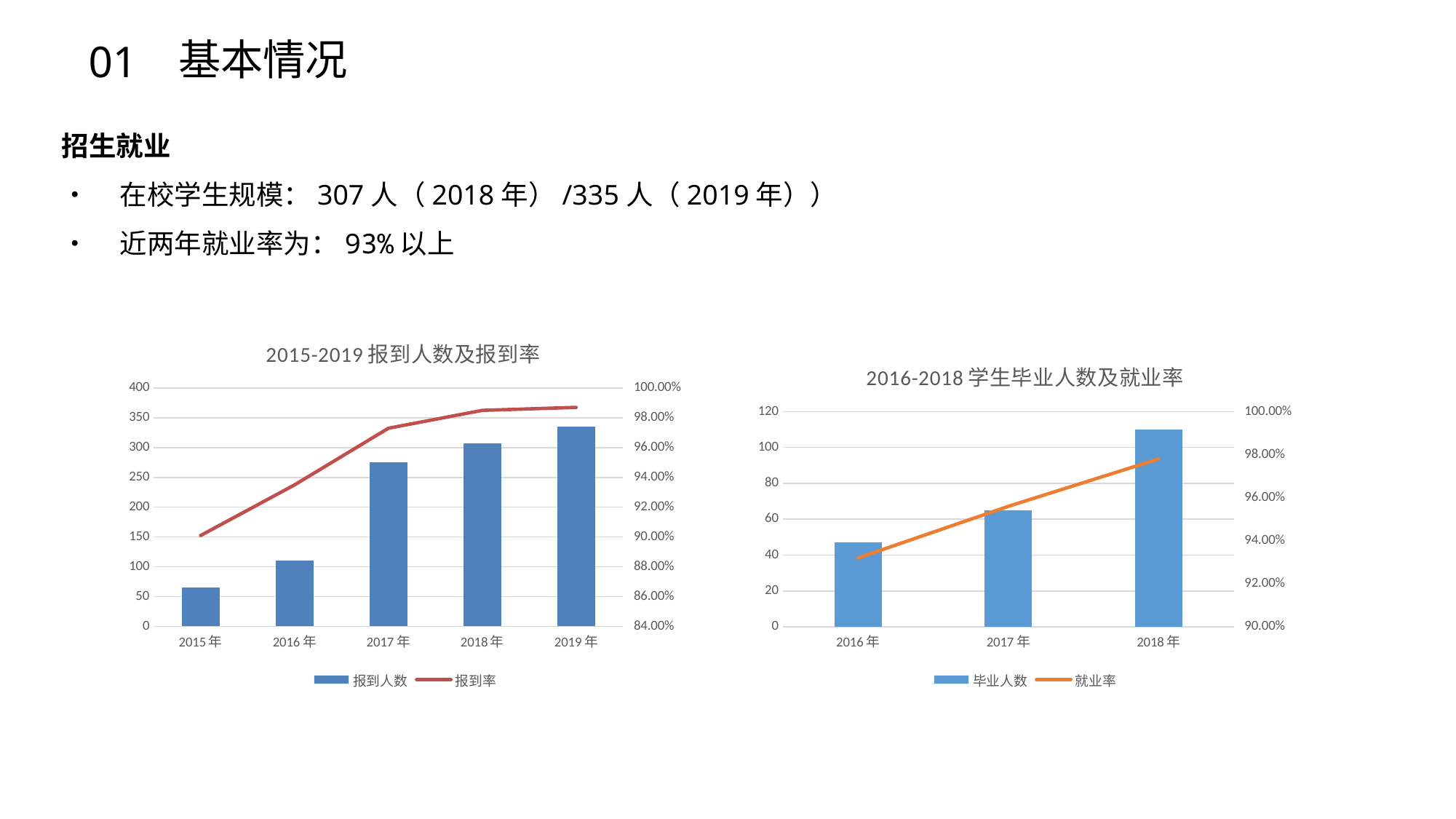
In the chart titled 2016-2018 学生毕业人数及就业率, which year has the highest 毕业人数 bar? 2018 年 In the chart titled 2015-2019 报到人数及报到率, is the 报到人数 value for 2015 年 greater or less than 100? less In the chart titled 2016-2018 学生毕业人数及就业率, is the 毕业人数 value for 2018 年 greater or less than 100? greater In the chart titled 2016-2018 学生毕业人数及就业率, is the 毕业人数 value for 2016 年 greater or less than 60? less In the chart titled 2015-2019 报到人数及报到率, which year has the highest 报到人数 bar? 2019 年 In the chart titled 2015-2019 报到人数及报到率, which year has the lowest 报到人数 bar? 2015 年 In the chart titled 2016-2018 学生毕业人数及就业率, which is larger, the 毕业人数 for 2017 年 or for 2016 年? 2017 年 In the chart titled 2015-2019 报到人数及报到率, how many series does the legend list? 2 In the chart titled 2016-2018 学生毕业人数及就业率, what colour is the 就业率 line? orange In the chart titled 2015-2019 报到人数及报到率, how many years are shown on the x axis? 5 In the chart titled 2015-2019 报到人数及报到率, does the 报到率 line rise or fall from 2015 年 to 2019 年? rise